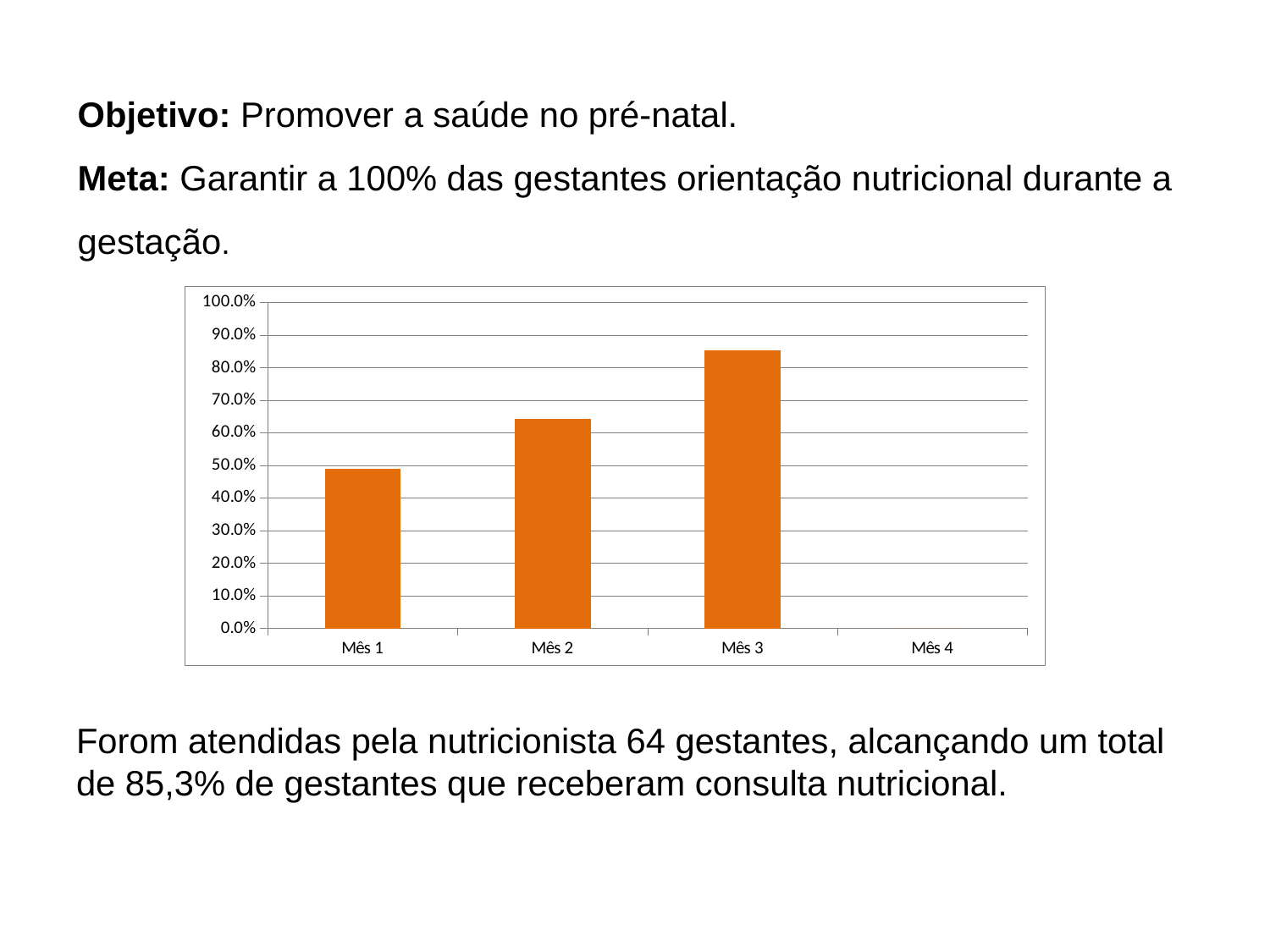
Do the bar values rise or fall from Mês 1 to Mês 3? Rise Among the months with a visible bar, which has the lowest value? Mês 1 Which month has the highest bar in the chart? Mês 3 Is the value for Mês 1 greater or less than 40.0%? greater Is the value for Mês 3 greater or less than 80.0%? greater What is the highest value shown on the chart's vertical axis? 100.0% Is the value for Mês 2 greater or less than 60.0%? greater What kind of chart is shown on the slide? Bar chart Which is larger, the value for Mês 2 or the value for Mês 3? Mês 3 How many categories are shown on the x axis of the chart? 4